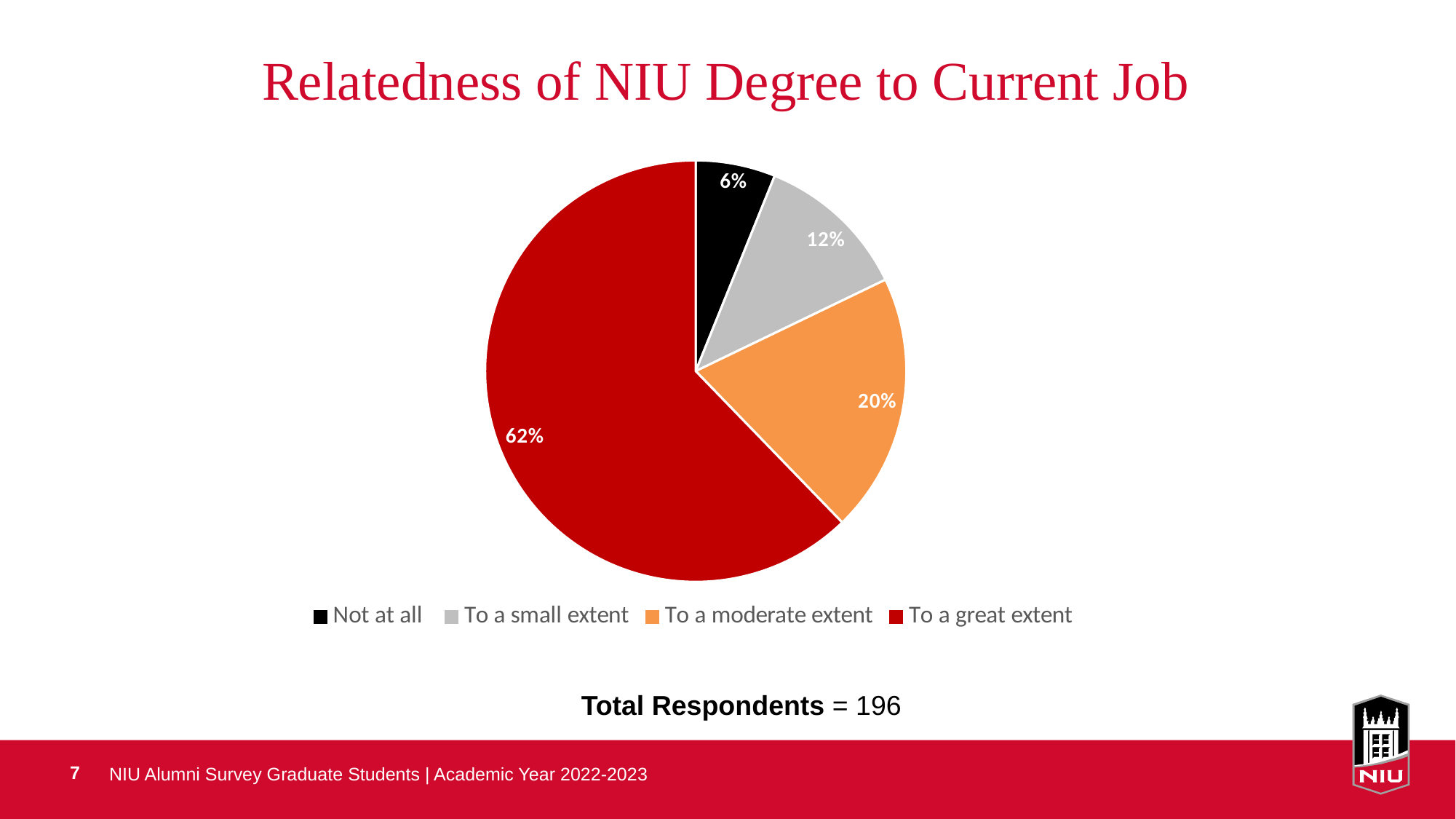
How many percentage points larger is the "To a great extent" slice than the "To a moderate extent" slice? 42 Which response category has the largest share of the pie? To a great extent What percentage of respondents answered "Not at all"? 6% Which response category has the smallest share of the pie? Not at all Which is larger, the share for "To a small extent" or the share for "Not at all"? To a small extent What percentage of respondents answered "To a great extent"? 62% What kind of chart is shown on the slide? pie chart How many slices does the pie chart have? 4 What percentage of respondents answered "To a small extent"? 12% What percentage of respondents answered "To a moderate extent"? 20% What is the title of the chart? Relatedness of NIU Degree to Current Job What colour is the "To a moderate extent" slice? orange